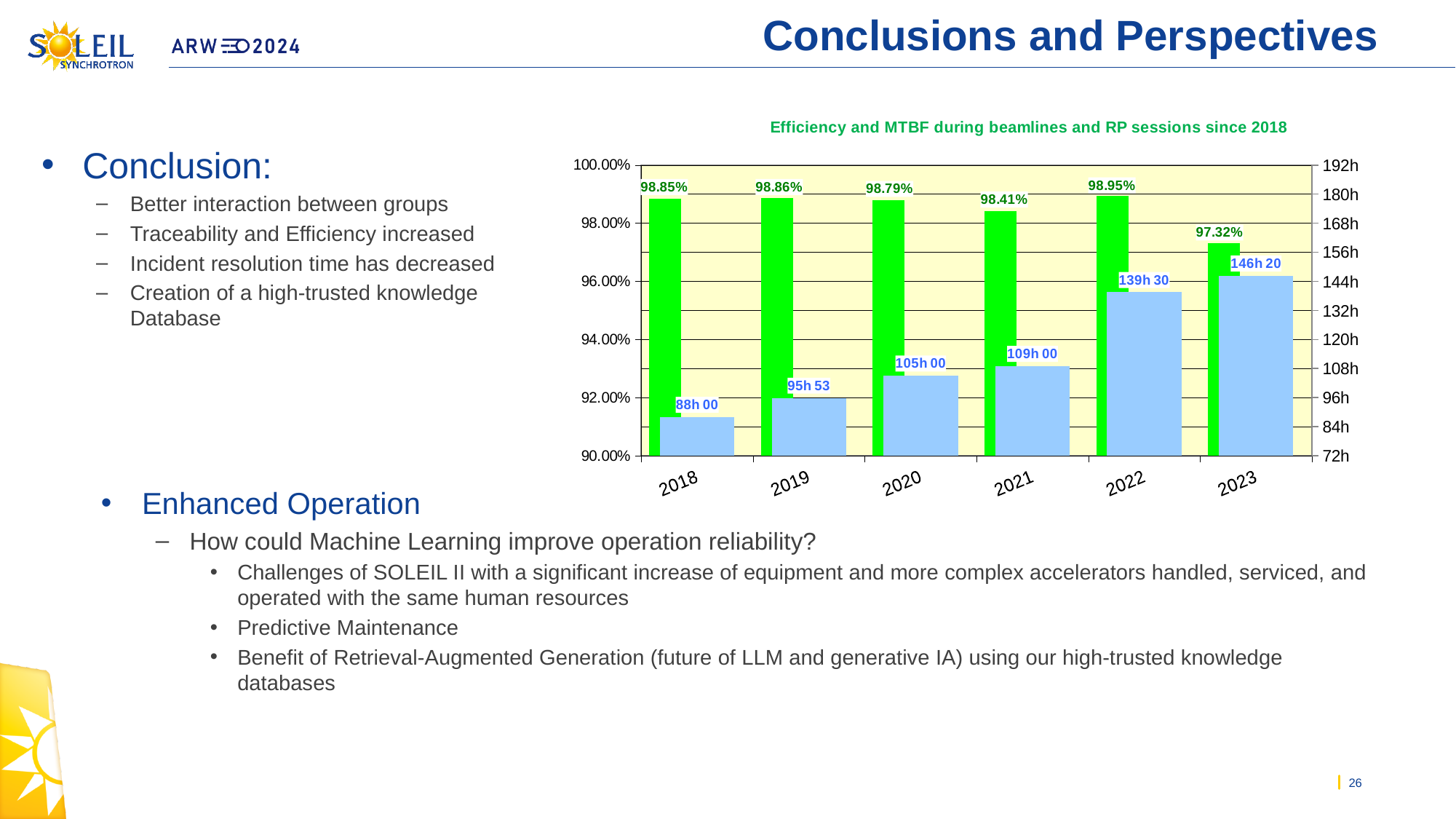
Which year has the highest efficiency value? 2022 What is the difference in efficiency between 2022 and 2023? 1.63% Which year has the highest MTBF value? 2023 How many years are shown on the x axis of the chart? 6 Which year has the lowest MTBF value? 2018 Which year has the larger efficiency value, 2020 or 2021? 2020 Do the MTBF values rise or fall from 2018 to 2023? rise What is the MTBF value shown for 2022? 139h 30 What is the efficiency value shown for 2018? 98.85% Which year has the lowest efficiency value? 2023 What is the MTBF value shown for 2019? 95h 53 Is the MTBF value for 2021 greater or less than 120h? less